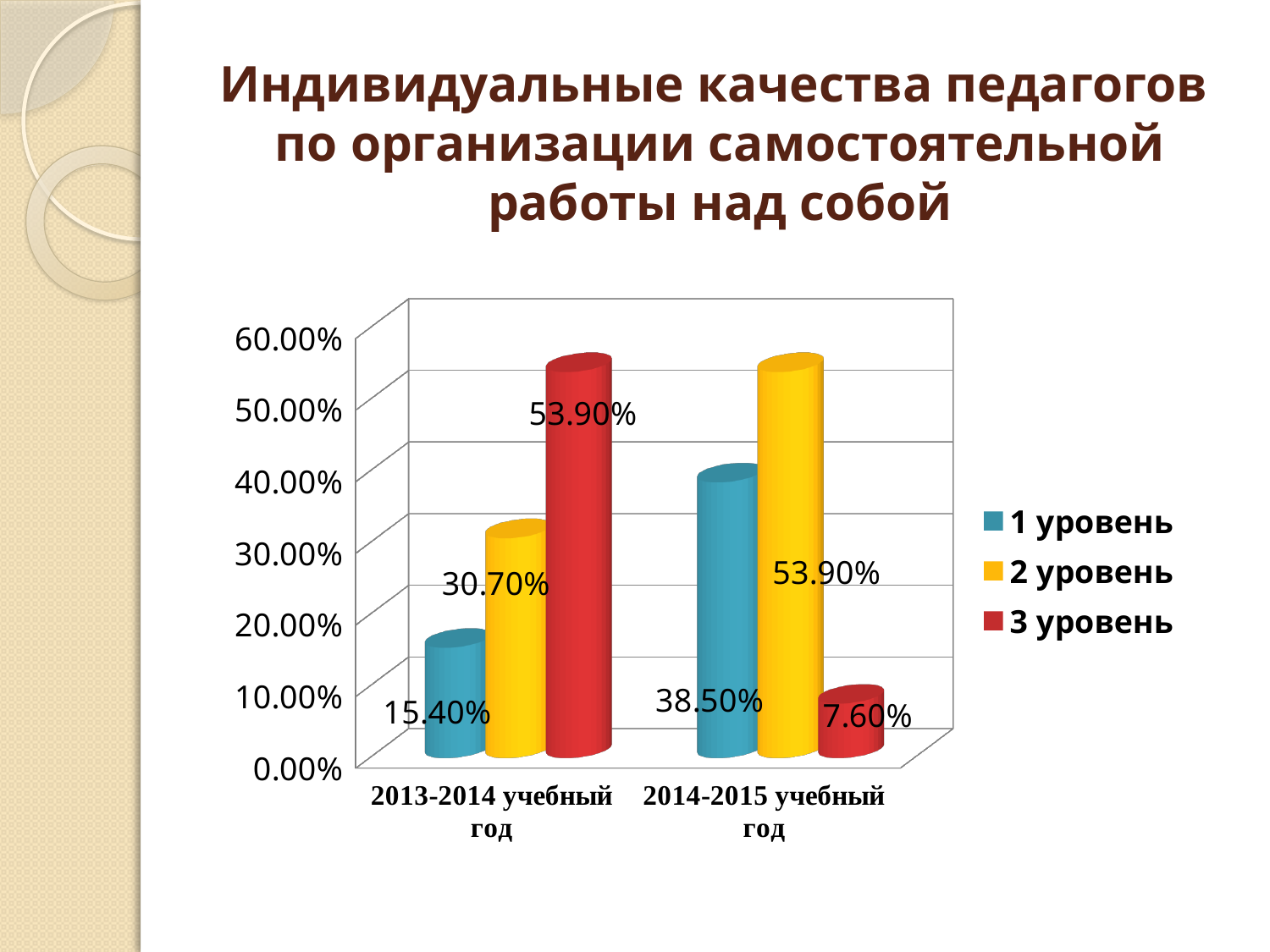
Is the value for 3 уровень in 2013-2014 учебный год greater or less than 50.00%? greater Which series has the highest value in 2013-2014 учебный год? 3 уровень What is the value for 3 уровень in 2014-2015 учебный год? 7.60% What is the value for 1 уровень in 2014-2015 учебный год? 38.50% What is the difference between the 1 уровень values for 2014-2015 учебный год and 2013-2014 учебный год? 23.10% How many series does the legend list? 3 What kind of chart is shown on the slide? bar chart How many categories are shown on the x axis? 2 Which is larger: 2 уровень in 2013-2014 учебный год or 2 уровень in 2014-2015 учебный год? 2 уровень in 2014-2015 учебный год Which series has the lowest value in 2014-2015 учебный год? 3 уровень What is the value for 1 уровень in 2013-2014 учебный год? 15.40% What is the value for 2 уровень in 2013-2014 учебный год? 30.70%